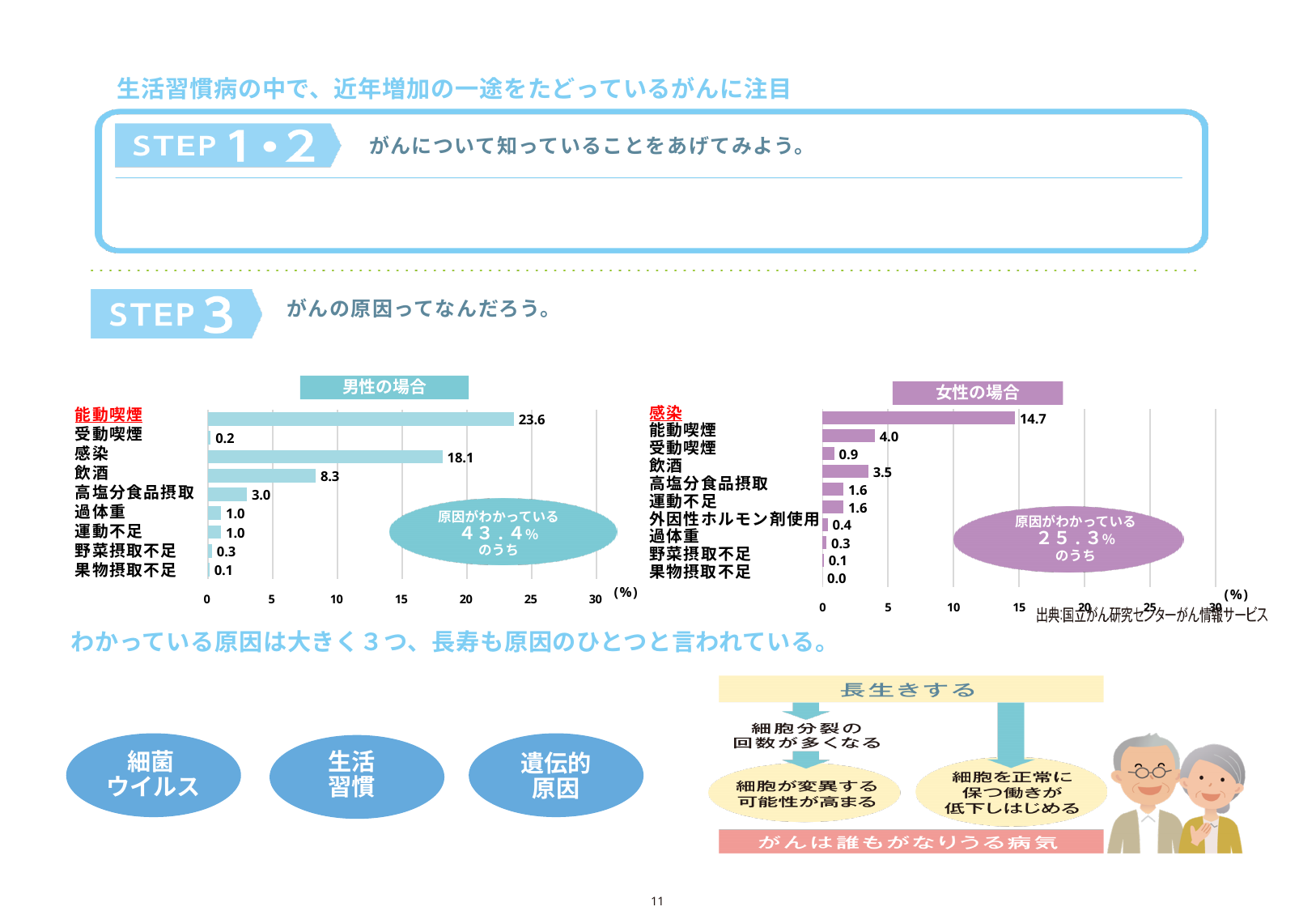
In the 女性の場合 chart, which category has the lowest value? 果物摂取不足 How many categories are shown in the 女性の場合 chart? 10 In the 女性の場合 chart, what is the value for 感染? 14.7 What kind of chart is the 男性の場合 chart? Bar chart In the 男性の場合 chart, what is the value for 能動喫煙? 23.6 In the 女性の場合 chart, what is the value for 外因性ホルモン剤使用? 0.4 In the 男性の場合 chart, what is the value for 飲酒? 8.3 In the 男性の場合 chart, which category has the highest value? 能動喫煙 How many categories are shown in the 男性の場合 chart? 9 In the 男性の場合 chart, what is the difference between the values for 能動喫煙 and 感染? 5.5 In the 女性の場合 chart, what is the difference between the values for 感染 and 能動喫煙? 10.7 In the 女性の場合 chart, which is larger, the value for 飲酒 or the value for 高塩分食品摂取? 飲酒